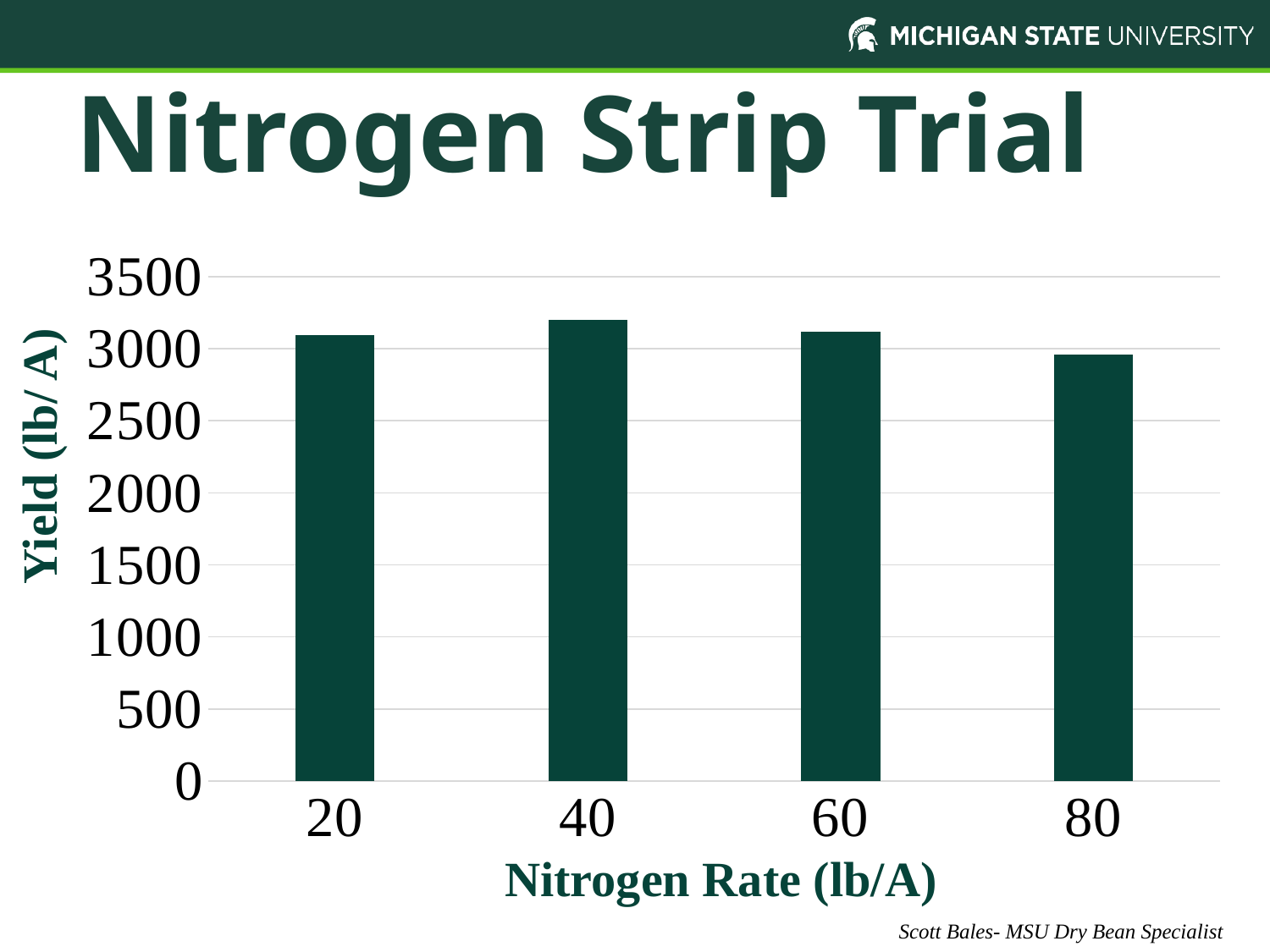
Which nitrogen rate has the highest yield? 40 What kind of chart is shown on the slide? bar chart Does yield rise or fall as the nitrogen rate increases from 40 to 80 lb/A? falls What is the title of the chart on the slide? Nitrogen Strip Trial Which nitrogen rate has the lowest yield? 80 Which has the higher yield, the 20 lb/A or the 80 lb/A nitrogen rate? 20 How many nitrogen rates (bars) are plotted in the chart? 4 Is the yield for the 60 lb/A nitrogen rate greater or less than 2500? greater Is the yield for the 80 lb/A nitrogen rate greater or less than 3500? less What is the label on the vertical axis of the chart? Yield (lb/A) Which has the higher yield, the 40 lb/A or the 80 lb/A nitrogen rate? 40 Is the yield for the 40 lb/A nitrogen rate greater or less than 3000? greater